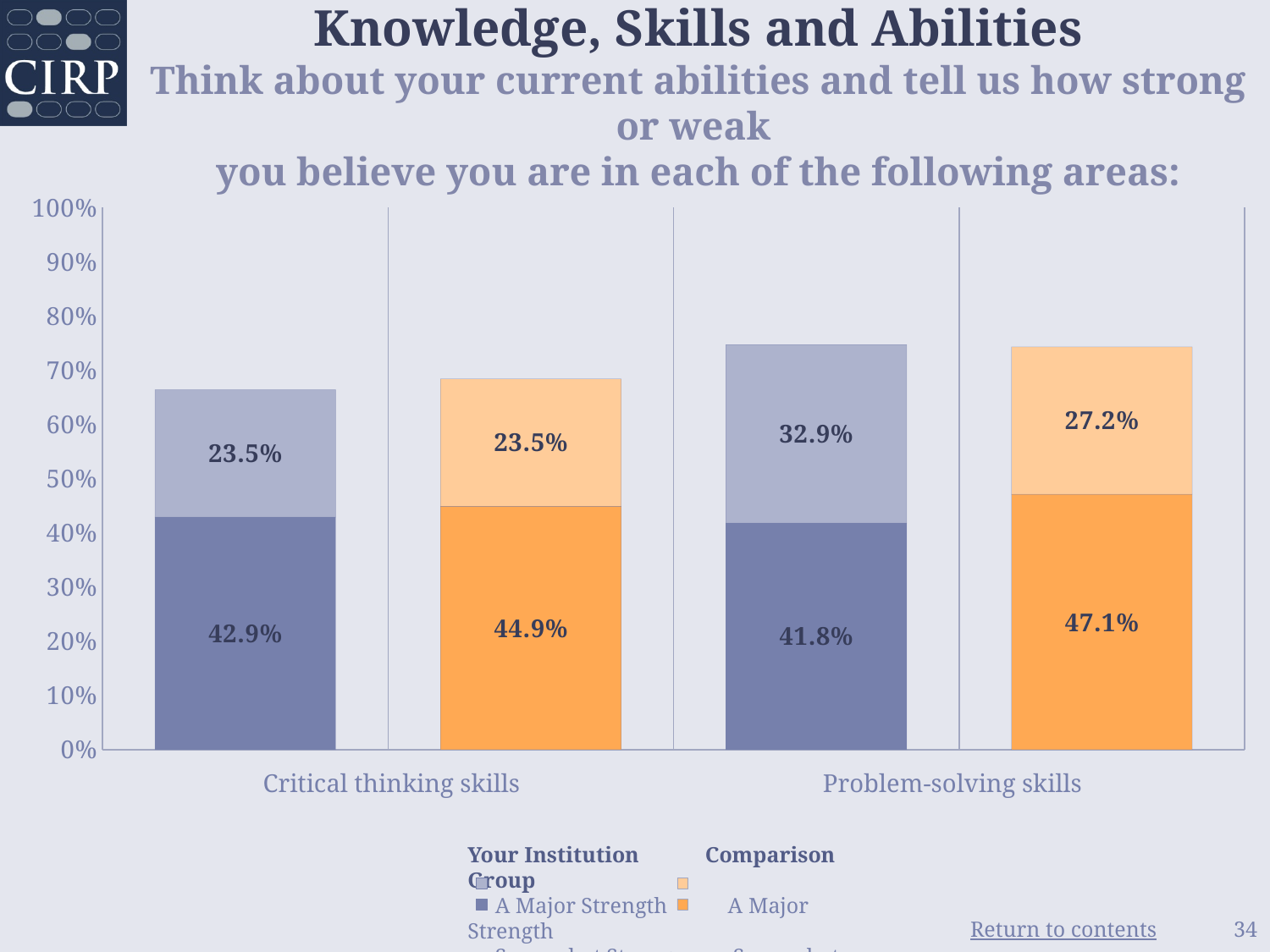
What is the difference between the Comparison Group's and Your Institution's 'A Major Strength' values for problem-solving skills? 5.3% What is the total height of the Your Institution stacked bar for problem-solving skills? 74.7% Which colour represents the Comparison Group's 'A Major Strength' segments? Orange What percentage of the Comparison Group rated problem-solving skills as 'A Major Strength'? 47.1% What percentage of Your Institution respondents rated critical thinking skills as 'A Major Strength'? 42.9% What value is shown in the upper (lighter) segment of the Your Institution bar for problem-solving skills? 32.9% Which group has the larger 'A Major Strength' value for problem-solving skills, Your Institution or the Comparison Group? Comparison Group What type of chart is shown on the slide? Stacked bar chart What value is shown in the upper (lighter) segment of the Comparison Group bar for critical thinking skills? 23.5% What is the difference between the Comparison Group's and Your Institution's 'A Major Strength' values for critical thinking skills? 2.0% How many skill areas are shown on the x axis of the chart? 2 What is the total height of the Comparison Group stacked bar for critical thinking skills? 68.4%